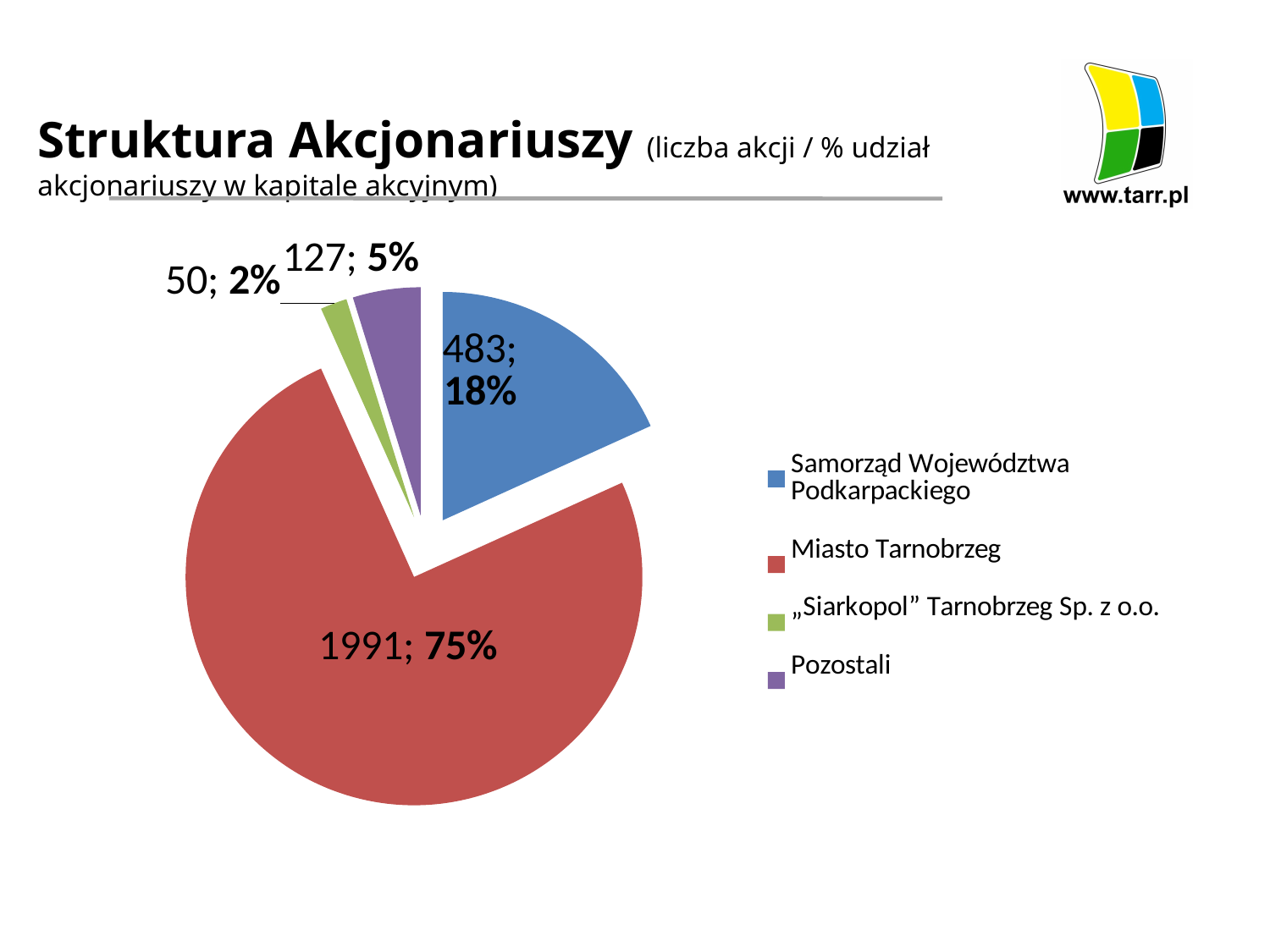
Which colour represents Miasto Tarnobrzeg in the pie chart? red How many shares does Miasto Tarnobrzeg hold according to the chart? 1991 What kind of chart is shown on the slide? pie chart What percentage share of the share capital does Samorząd Województwa Podkarpackiego hold? 18% Which shareholder holds the largest share of the share capital? Miasto Tarnobrzeg How many shares does Samorząd Województwa Podkarpackiego hold? 483 How many more shares does Miasto Tarnobrzeg hold than Samorząd Województwa Podkarpackiego? 1508 Which shareholder holds the smallest share of the share capital? "Siarkopol" Tarnobrzeg Sp. z o.o. How many shareholder categories does the pie chart show? 4 What percentage share does "Siarkopol" Tarnobrzeg Sp. z o.o. hold? 2% Who holds more shares, Pozostali or "Siarkopol" Tarnobrzeg Sp. z o.o.? Pozostali How many shares are held by Pozostali? 127